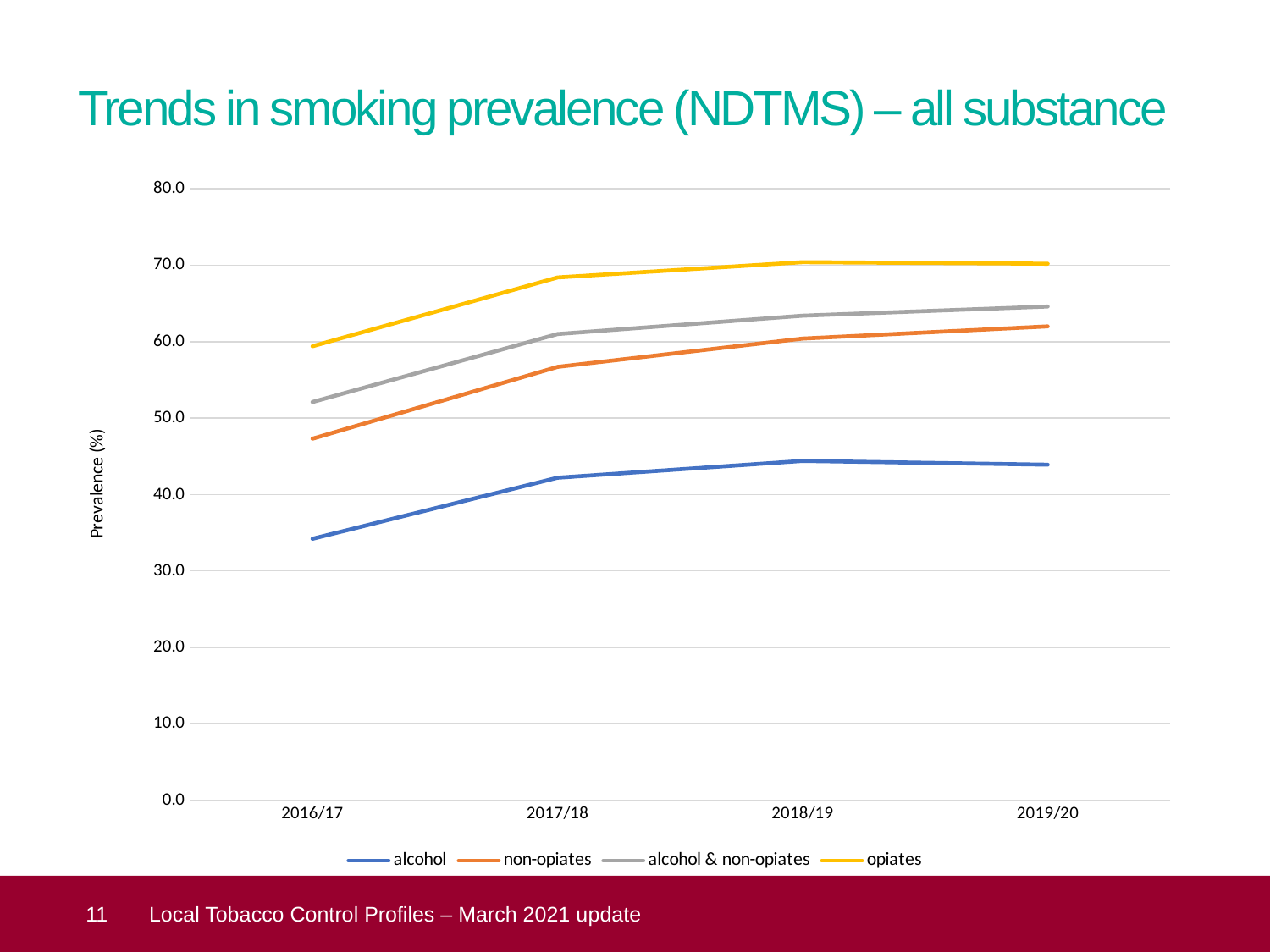
Is the value for opiates in 2017/18 greater or less than 60.0? greater What is the label on the y axis? Prevalence (%) What kind of chart is shown on the slide? line chart How many time periods are shown on the x axis? 4 In 2016/17, which is larger: the value for alcohol & non-opiates or the value for non-opiates? alcohol & non-opiates Which series has the highest smoking prevalence in 2019/20? opiates Is the value for alcohol & non-opiates in 2019/20 greater or less than 60.0? greater Is the value for non-opiates in 2016/17 greater or less than 50.0? less How many series does the legend list? 4 Which series has the lowest smoking prevalence in 2016/17? alcohol Does the alcohol series rise or fall between 2016/17 and 2018/19? rise